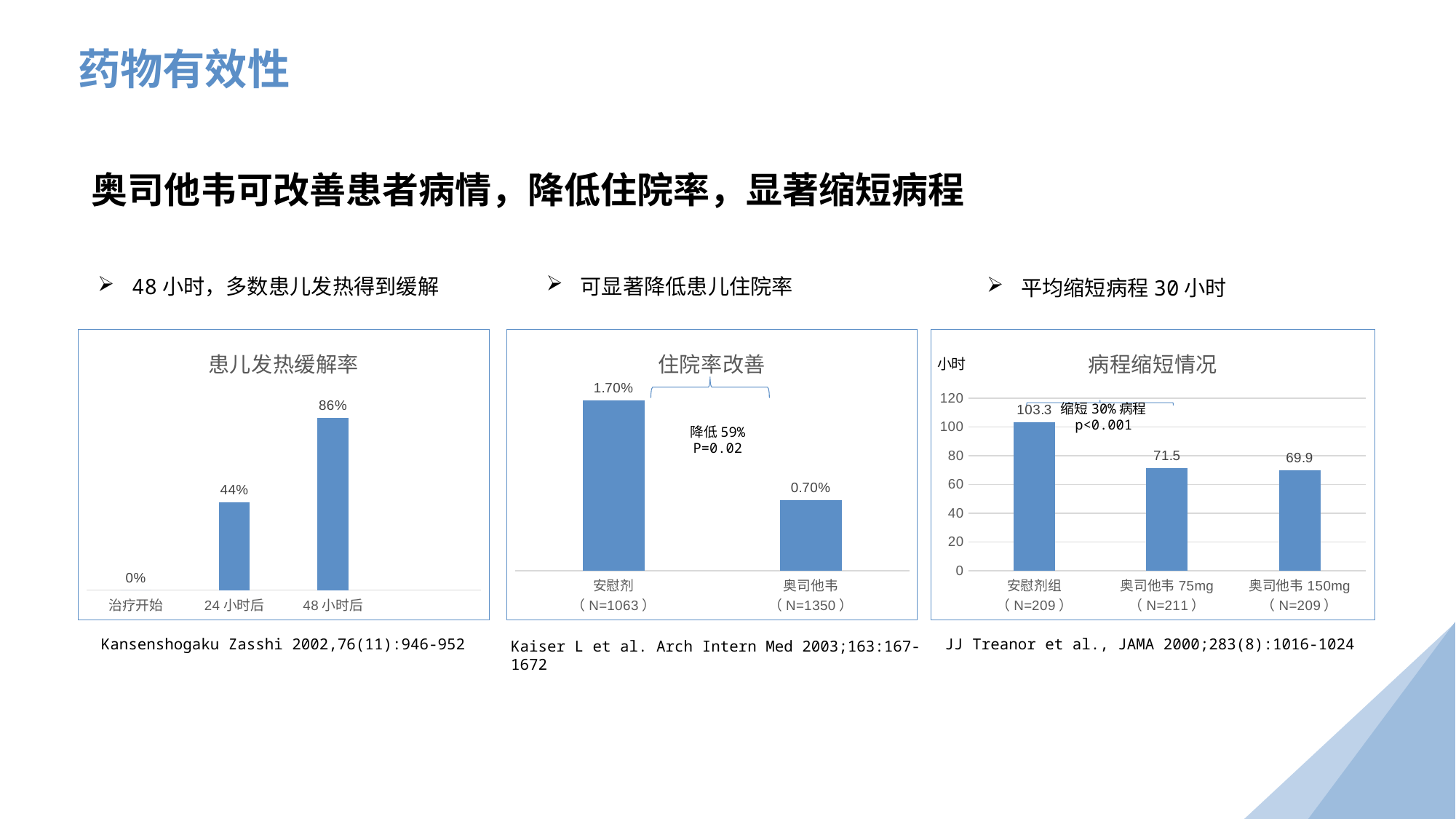
In the chart titled 病程缩短情况, what is the value for 奥司他韦 75mg (N=211)? 71.5 In the chart titled 患儿发热缓解率, what is the value for 24 小时后? 44% In the chart titled 住院率改善, which category has the lower value? 奥司他韦 (N=1350) In the chart titled 病程缩短情况, which category has the highest value? 安慰剂组 (N=209) In the chart titled 住院率改善, what is the value for 奥司他韦 (N=1350)? 0.70% In the chart titled 患儿发热缓解率, what is the value for 48 小时后? 86% In the chart titled 患儿发热缓解率, what is the difference between the values for 48 小时后 and 24 小时后? 42% In the chart titled 患儿发热缓解率, how many categories are shown on the x axis? 3 In the chart titled 患儿发热缓解率, do the values rise or fall from 治疗开始 to 48 小时后? rise In the chart titled 病程缩短情况, what is the value for 安慰剂组 (N=209)? 103.3 In the chart titled 住院率改善, what is the value for 安慰剂 (N=1063)? 1.70% What kind of chart is the chart titled 病程缩短情况? bar chart